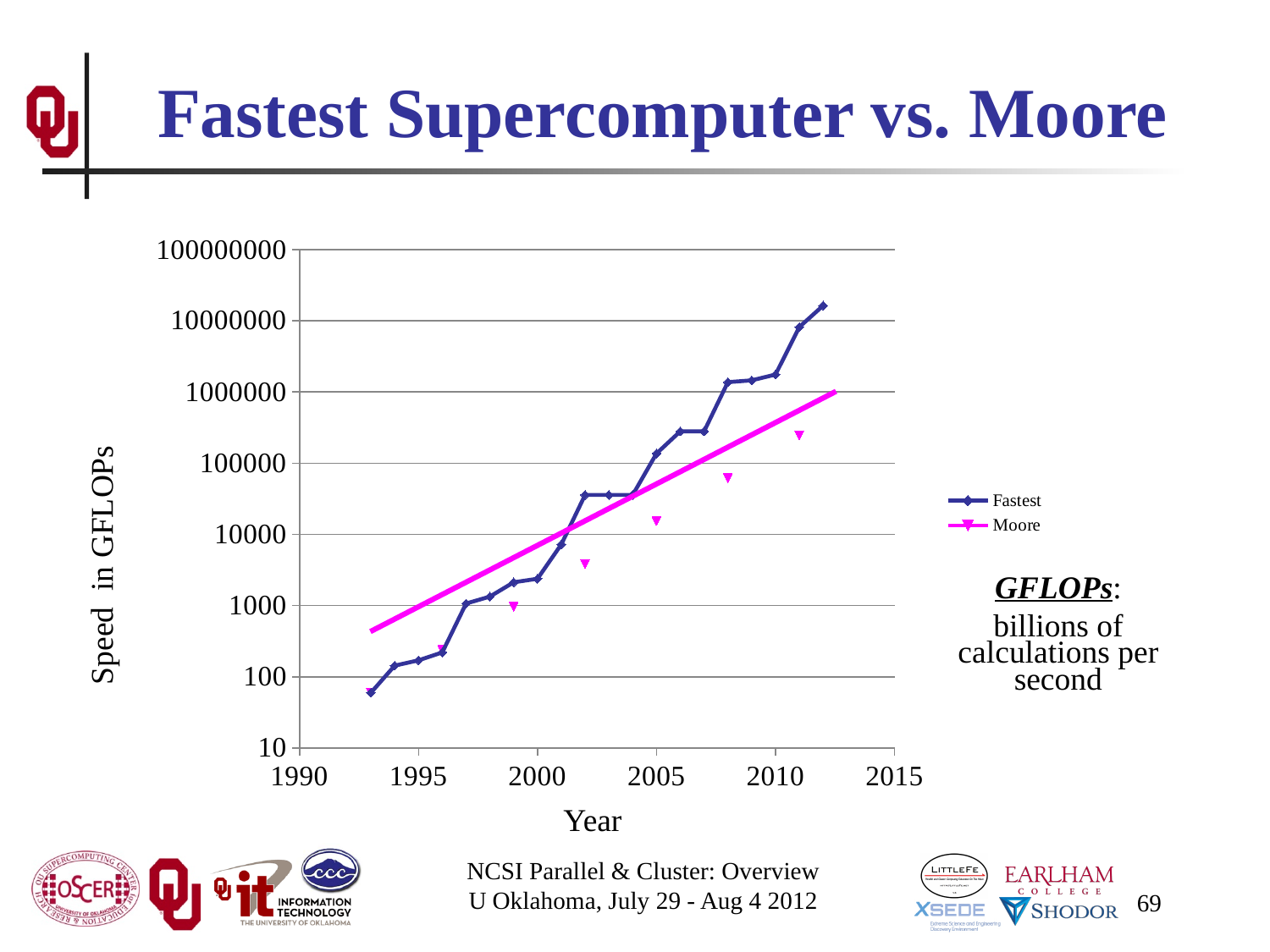
How many series does the legend list? 2 Is the Fastest value for 1993 greater or less than 100? less Is the Moore value for 2011 greater or less than 1000000? less What kind of chart is shown on the slide? line chart What is the label on the vertical axis? Speed in GFLOPs Is the Fastest value for 2010 greater or less than 1000000? greater Does the Fastest series rise or fall as the year increases? rise In 2011, which series has the higher value, Fastest or Moore? Fastest What are the two series named in the legend? Fastest and Moore